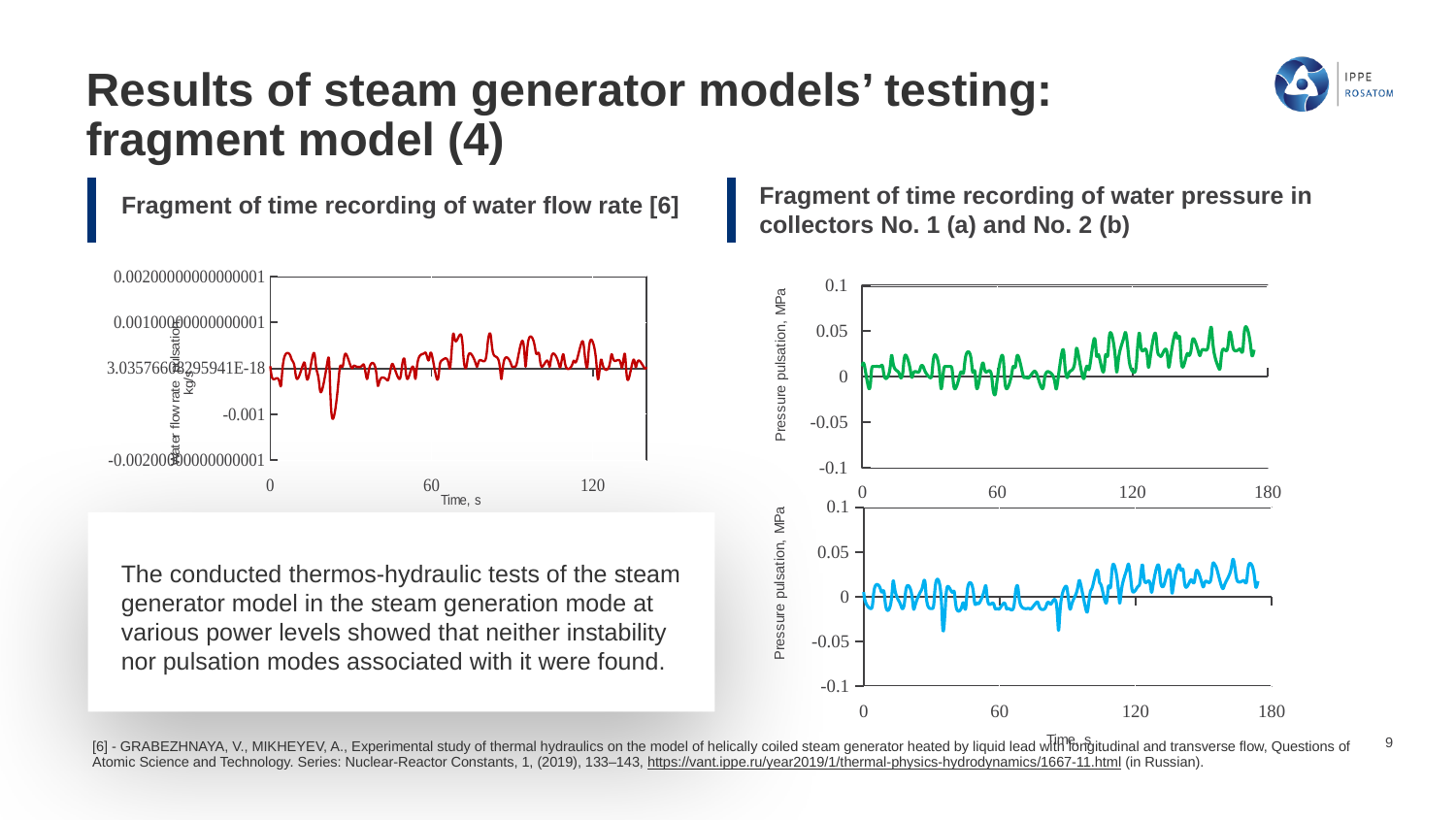
What kind of chart is the 'Fragment of time recording of water flow rate' chart on the left? line chart In the bottom right chart (collector No. 2), are the pressure pulsation values greater or less than -0.1 MPa throughout the recording? greater In the top right chart (collector No. 1), do the pressure pulsation values shift upward or downward after about 90 s? upward What is the x-axis label of the water flow rate chart on the left? Time, s What is the y-axis label of the two pressure charts on the right? Pressure pulsation, MPa How many charts are shown on the slide in total? 3 In the top right chart (collector No. 1), are the pressure pulsation values greater or less than 0.1 MPa throughout the recording? less